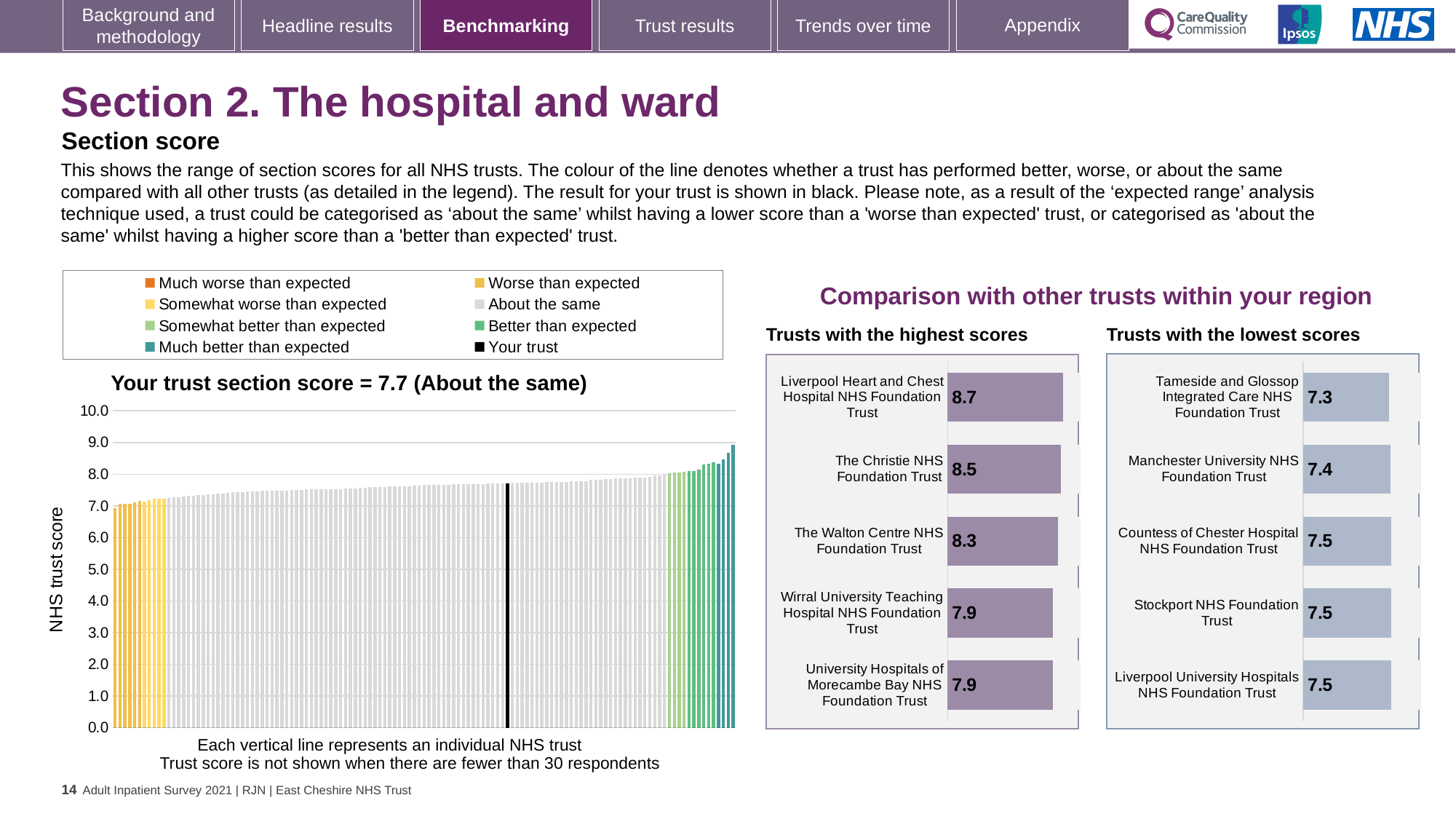
On the 'Your trust section score' chart, do the trust scores rise or fall from left to right? rise On the 'Your trust section score' chart, what is the label on the vertical axis? NHS trust score How many entries does the legend above the 'Your trust section score' chart list? 8 On the 'Trusts with the highest scores' chart, what is the score for The Christie NHS Foundation Trust? 8.5 On the 'Trusts with the lowest scores' chart, what is the score for Manchester University NHS Foundation Trust? 7.4 On the 'Your trust section score' chart, what is the section score for your trust? 7.7 On the 'Trusts with the lowest scores' chart, which trust has the lowest score? Tameside and Glossop Integrated Care NHS Foundation Trust On the 'Trusts with the highest scores' chart, what is the difference between the scores of Liverpool Heart and Chest Hospital NHS Foundation Trust and The Walton Centre NHS Foundation Trust? 0.4 On the 'Your trust section score' chart, is the value of the tallest bar greater or less than 8.0? greater How many trusts are shown on the 'Trusts with the lowest scores' chart? 5 On the 'Trusts with the highest scores' chart, which trust has the highest score? Liverpool Heart and Chest Hospital NHS Foundation Trust On the 'Your trust section score' chart, what kind of chart is shown? bar chart